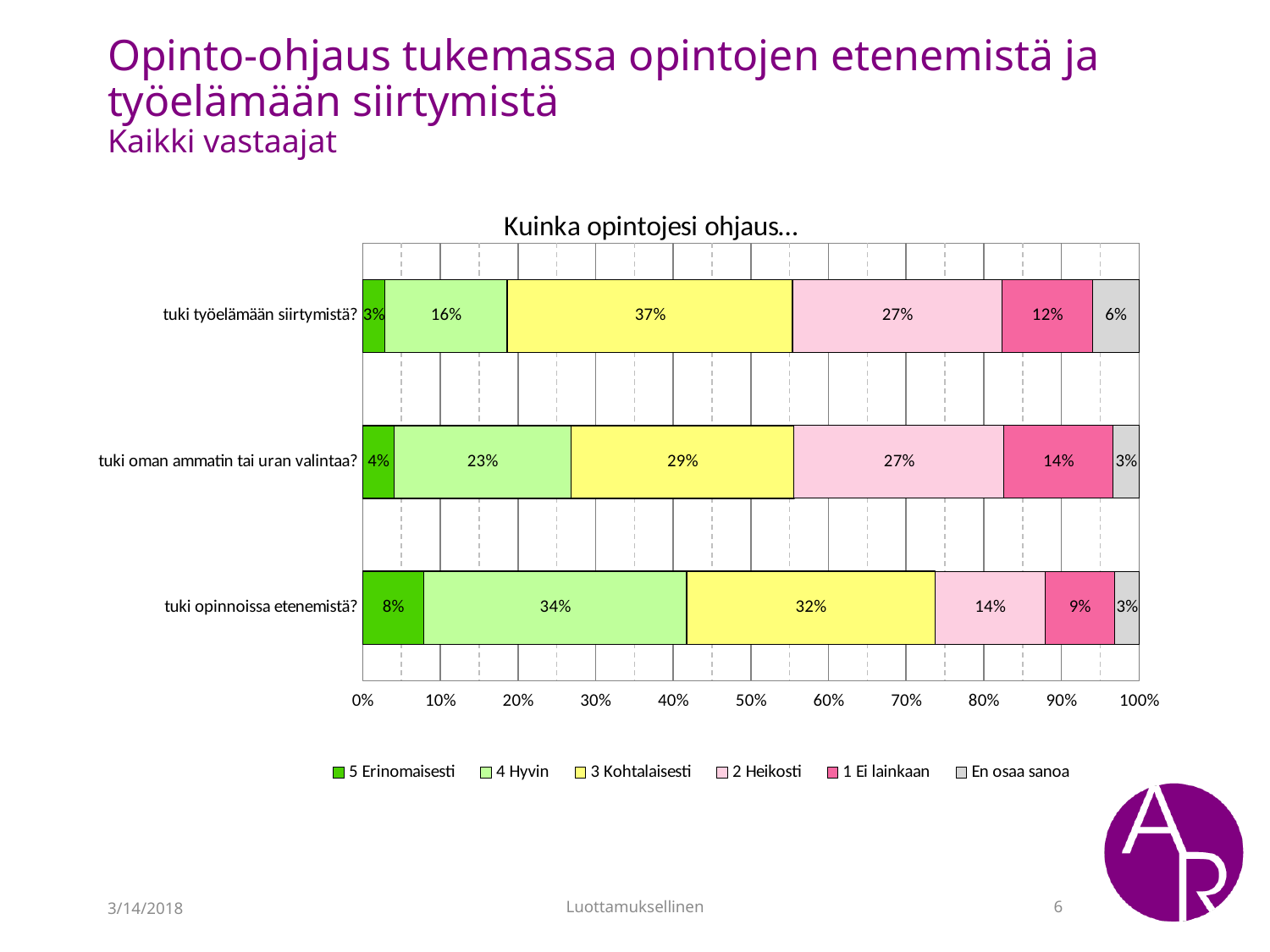
What is the value of '5 Erinomaisesti' for 'tuki opinnoissa etenemistä?'? 8% How many categories are plotted on the chart? 3 What is the difference between the '2 Heikosti' values for 'tuki työelämään siirtymistä?' and 'tuki opinnoissa etenemistä?'? 13% What is the value of '4 Hyvin' for 'tuki oman ammatin tai uran valintaa?'? 23% What is the chart's title? Kuinka opintojesi ohjaus... Which category has the lowest value for '4 Hyvin'? tuki työelämään siirtymistä? What is the value of 'En osaa sanoa' for 'tuki työelämään siirtymistä?'? 6% What kind of chart is shown on the slide? Stacked bar chart How many series does the legend list? 6 What is the value of '3 Kohtalaisesti' for 'tuki työelämään siirtymistä?'? 37% Which is larger: the '1 Ei lainkaan' value for 'tuki oman ammatin tai uran valintaa?' or for 'tuki opinnoissa etenemistä?'? tuki oman ammatin tai uran valintaa? Which category has the highest value for '5 Erinomaisesti'? tuki opinnoissa etenemistä?